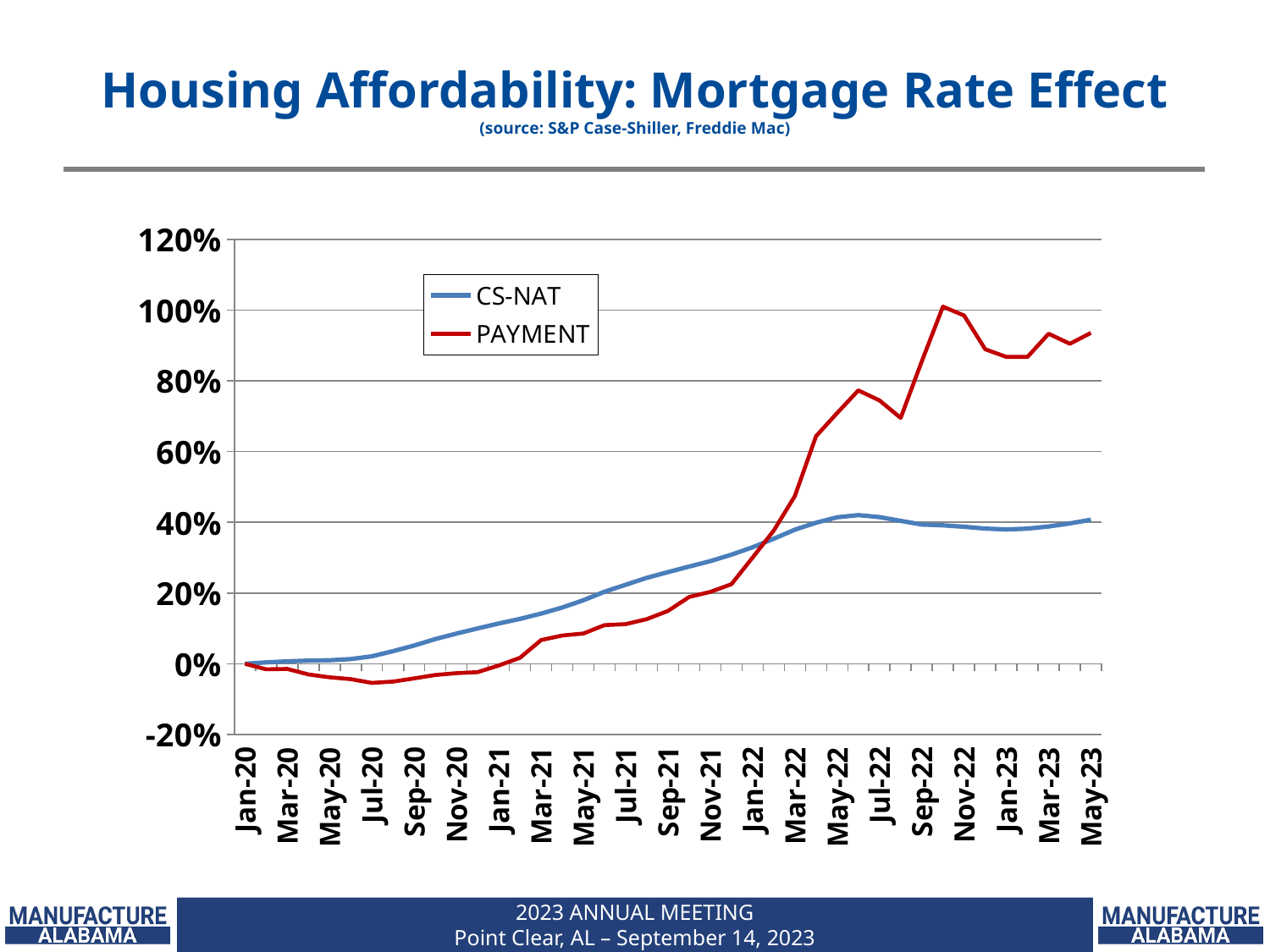
What is the title of the chart on the slide? Housing Affordability: Mortgage Rate Effect Is the value for CS-NAT at Jan-22 greater or less than 20%? greater Does the CS-NAT line rise or fall from Jan-20 to May-22? rise Is the value for CS-NAT at Jul-20 greater or less than 20%? less Is the value for PAYMENT at Jul-22 greater or less than 60%? greater How many series does the legend list? 2 What are the two series named in the legend? CS-NAT and PAYMENT At May-23, which series has the larger value, CS-NAT or PAYMENT? PAYMENT At Jul-20, which series has the larger value, CS-NAT or PAYMENT? CS-NAT What kind of chart is shown on the slide? line chart